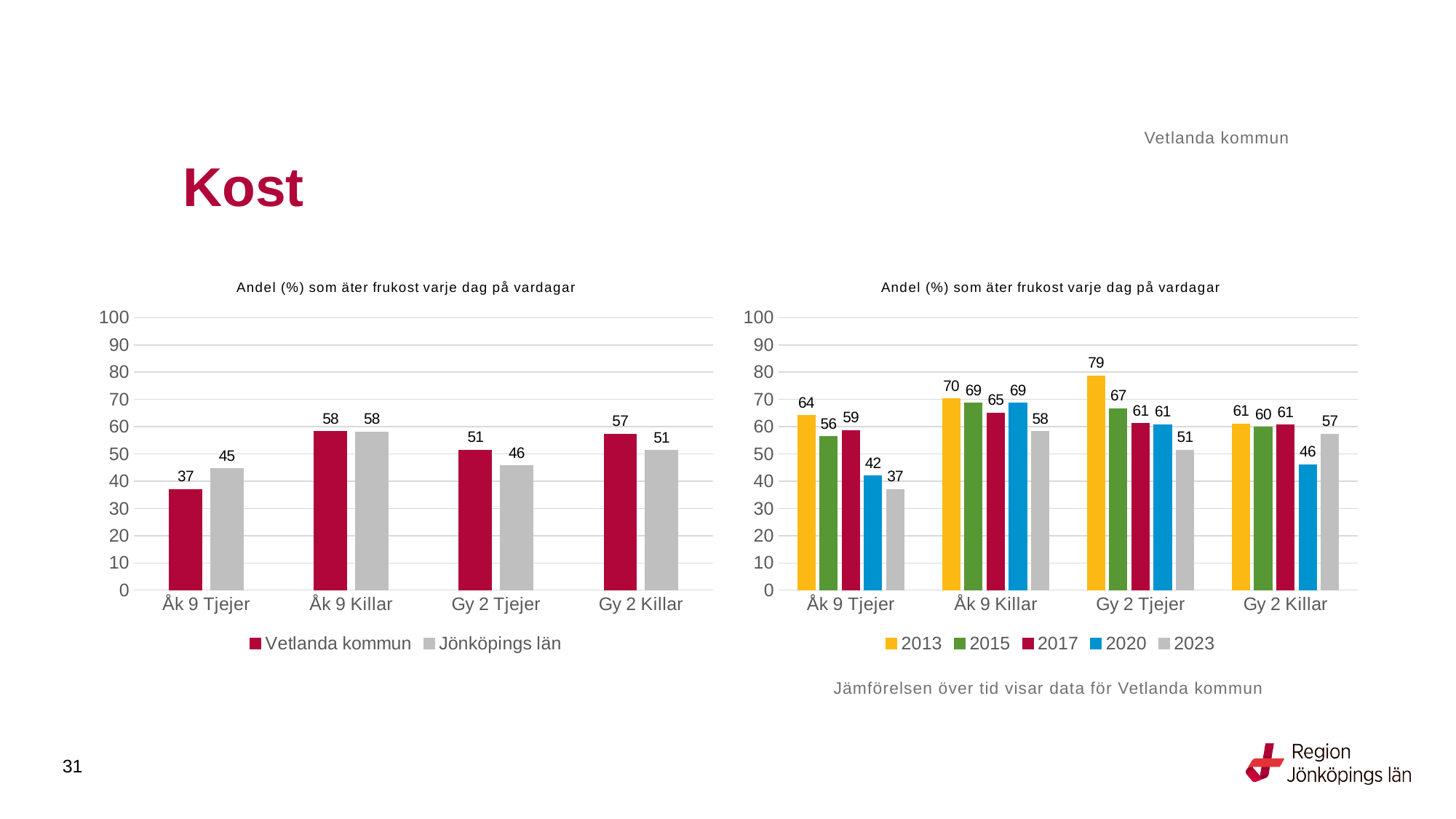
In the left chart, what is the difference between Vetlanda kommun and Jönköpings län for Åk 9 Tjejer? 8 In the left chart, which category has the lowest value for Vetlanda kommun? Åk 9 Tjejer In the right chart, how many series does the legend list? 5 In the left chart, what is the value for Vetlanda kommun for Åk 9 Tjejer? 37 In the right chart, how does the value for Åk 9 Tjejer change from 2013 to 2023? It falls In the right chart, is the 2020 value for Gy 2 Killar larger or smaller than the 2023 value for Gy 2 Killar? smaller In the left chart, how many series does the legend list? 2 In the left chart, what is the value for Jönköpings län for Gy 2 Killar? 51 In the right chart, which category has the highest value for 2013? Gy 2 Tjejer What kind of chart is the left chart? Bar chart In the right chart, what is the value for 2023 for Åk 9 Tjejer? 37 In the right chart, what is the value for 2013 for Gy 2 Tjejer? 79